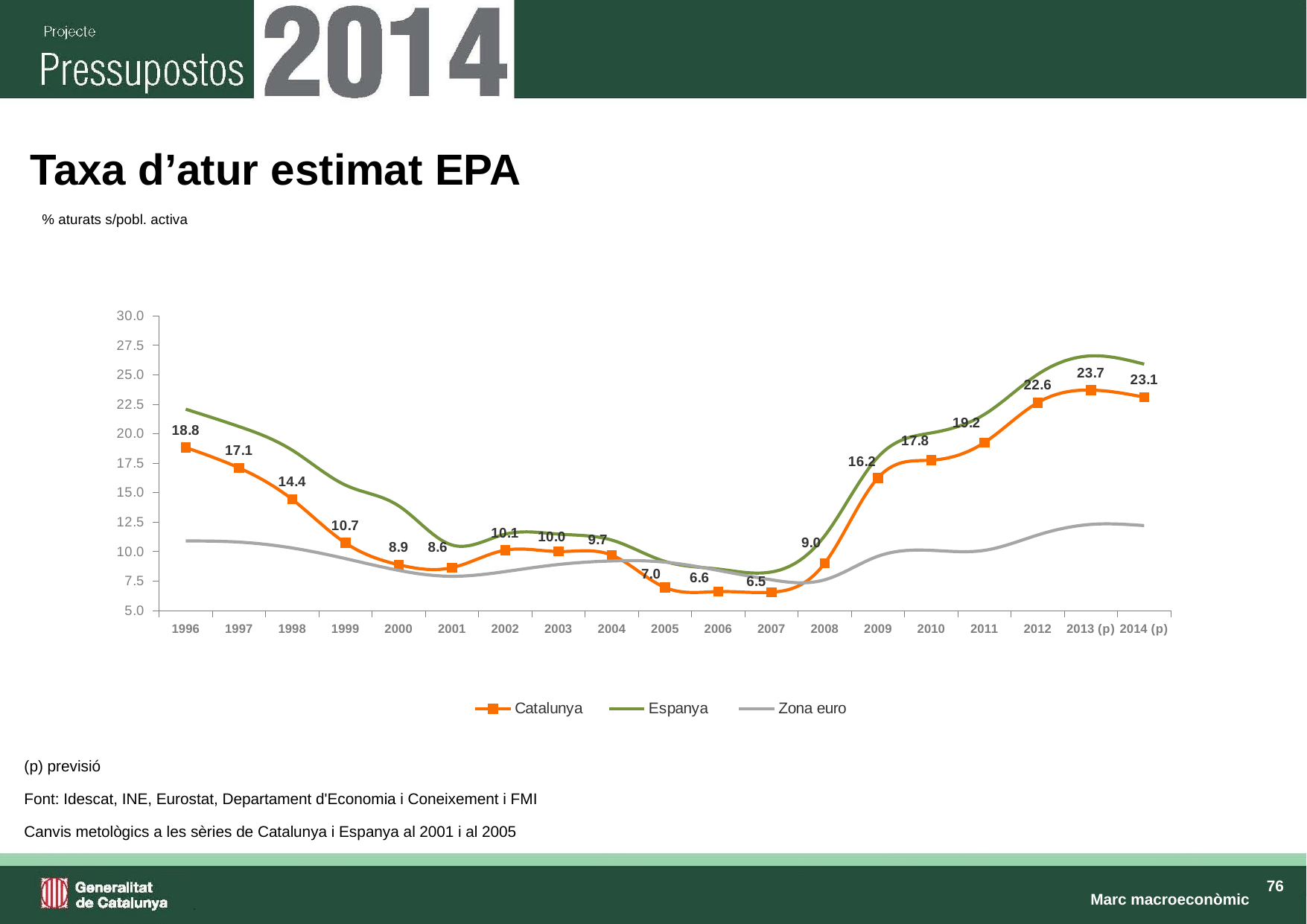
What is the Catalunya unemployment rate shown for 1996? 18.8 Is the Zona euro value for 2001 greater or less than 10.0? less How many series does the legend list? 3 How many years are shown on the x axis? 19 What value is labelled for Catalunya in 2009? 16.2 What kind of chart is shown on the slide? Line chart What is the difference between the Catalunya values for 2013 (p) and 2014 (p)? 0.6 What is the Catalunya value for 2014 (p)? 23.1 Is the Espanya value for 2013 (p) greater or less than 25.0? greater Which is larger for Catalunya: the value in 2002 or the value in 2005? 2002 In which year does the Catalunya series reach its highest labelled value? 2013 (p) In which year is the Catalunya series at its lowest labelled value? 2007